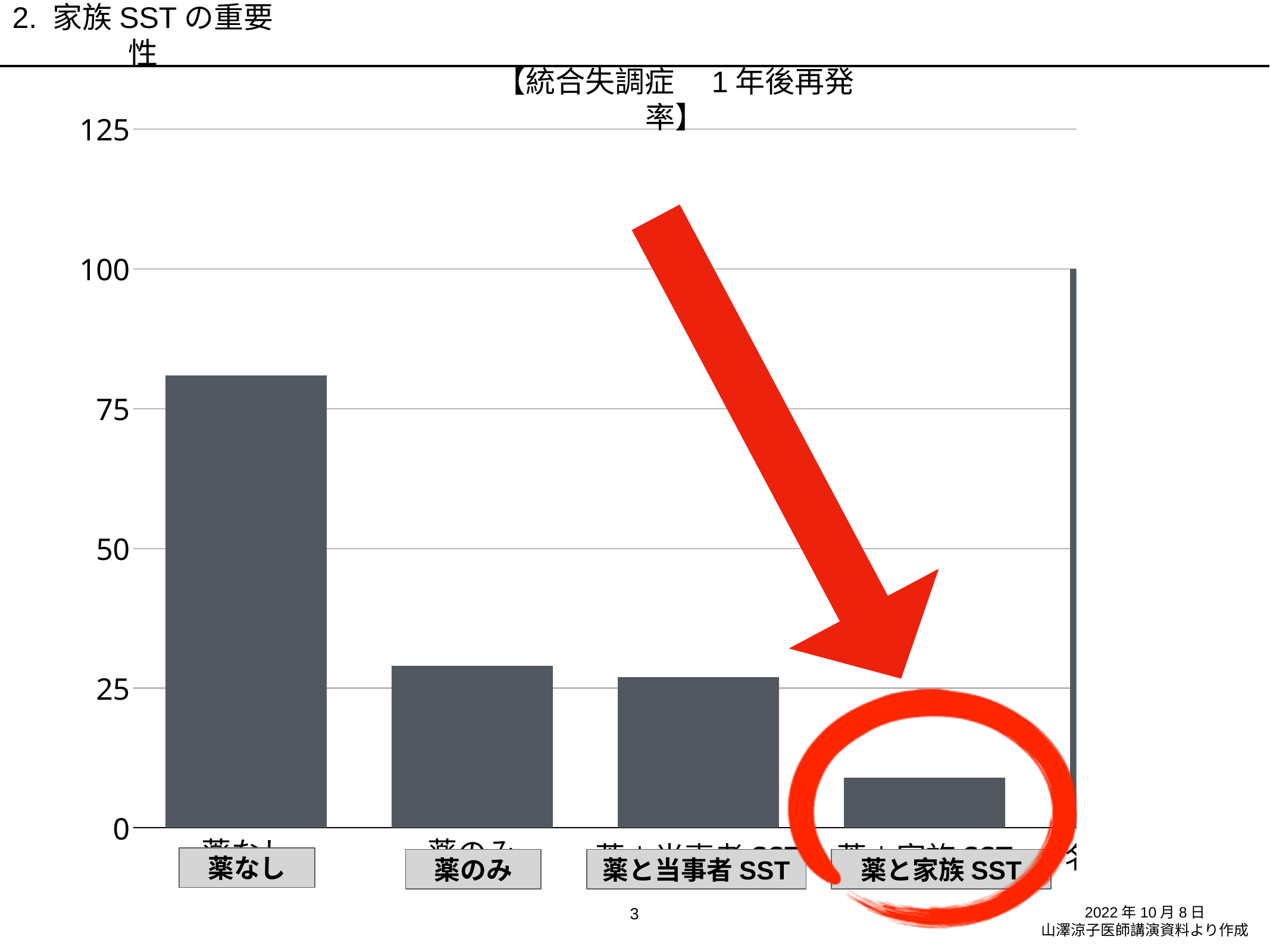
What kind of chart is shown on the slide? bar chart Which is larger, the value for 薬なし or the value for 薬のみ? 薬なし Is the value for 薬のみ greater or less than 50? less Which category has the lowest 1-year relapse rate? 薬と家族SST Is the value for 薬なし greater or less than 100? less Which category has the highest 1-year relapse rate? 薬なし Is the value for 薬なし greater or less than 75? greater Do the values rise or fall moving from left to right along the x axis? fall Which category is circled in red on the chart? 薬と家族SST Which is larger, the value for 薬と当事者SST or the value for 薬と家族SST? 薬と当事者SST